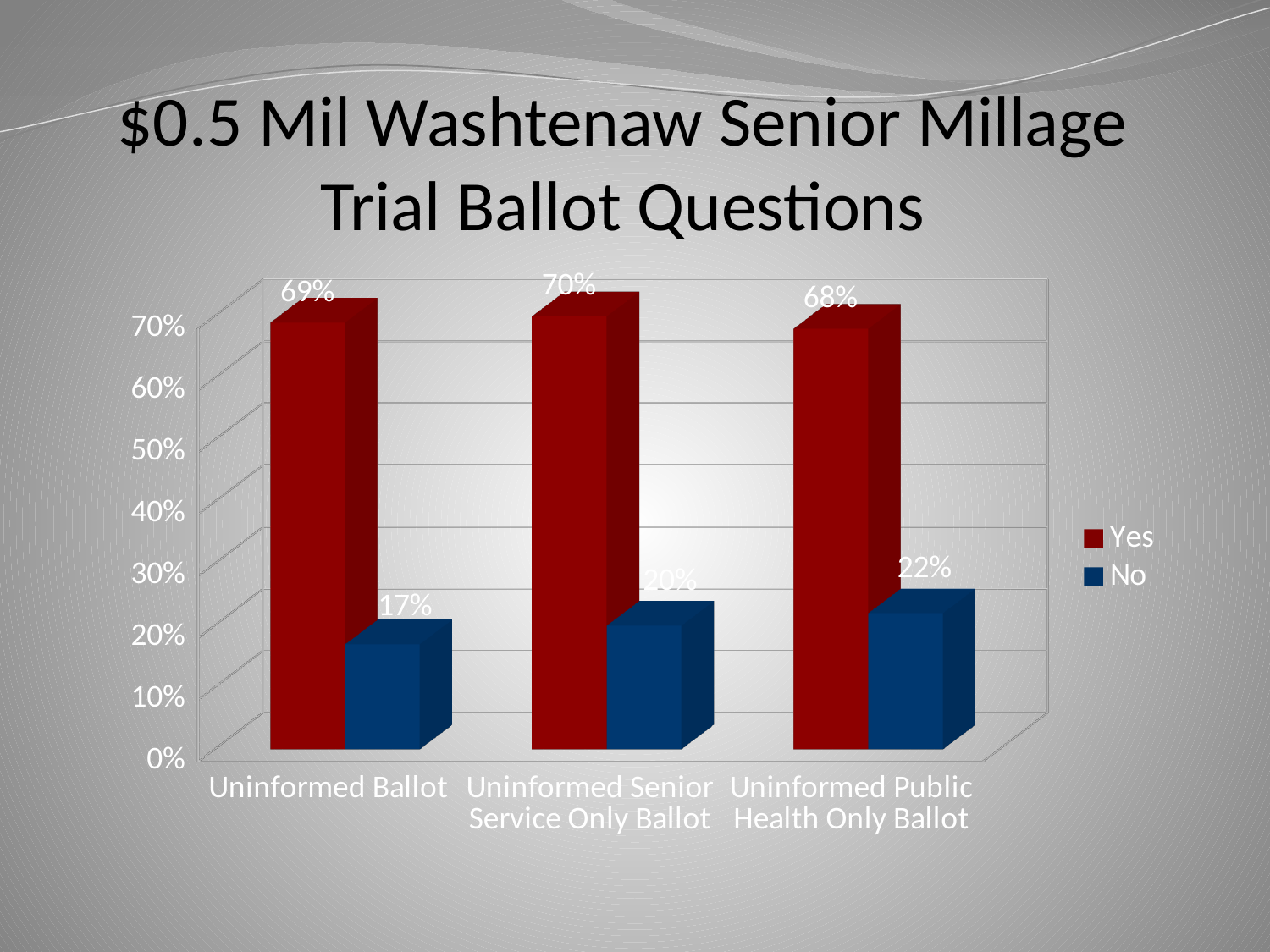
Which category has the highest Yes value? Uninformed Senior Service Only Ballot What kind of chart is shown on the slide? Bar chart Which is larger, the No value for Uninformed Public Health Only Ballot or the No value for Uninformed Ballot? Uninformed Public Health Only Ballot What is the No value for Uninformed Senior Service Only Ballot? 20% What is the Yes value for Uninformed Public Health Only Ballot? 68% What is the Yes value for Uninformed Ballot? 69% What is the difference between the Yes and No values for Uninformed Ballot? 52% Which category has the lowest No value? Uninformed Ballot How many categories are shown on the x axis? 3 How many series does the legend list? 2 What is the title of the chart on the slide? $0.5 Mil Washtenaw Senior Millage Trial Ballot Questions What is the No value for Uninformed Public Health Only Ballot? 22%